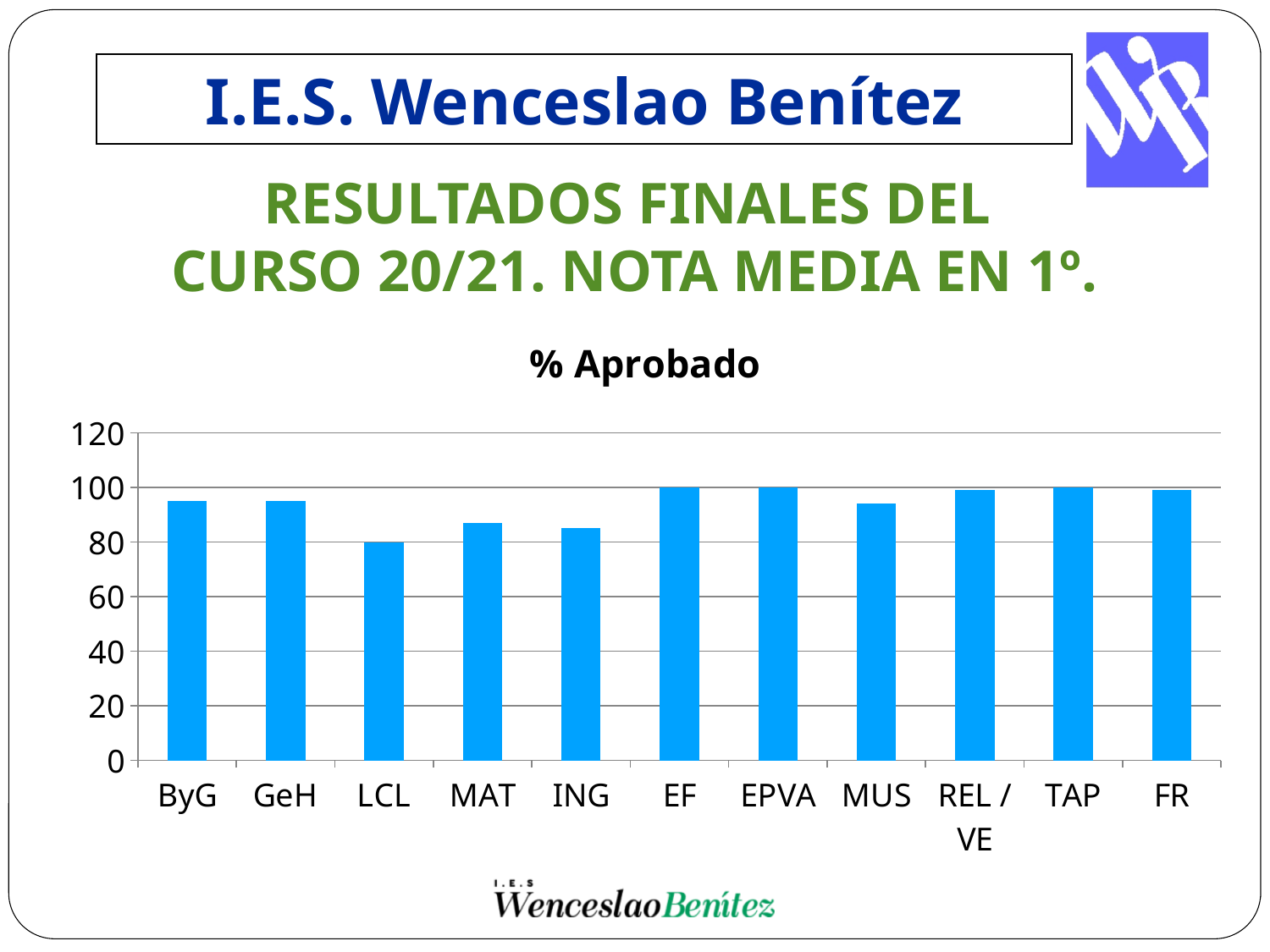
What is the % Aprobado value for EF? 100 Which has a higher % Aprobado, ING or ByG? ByG Which has a higher % Aprobado, MAT or LCL? MAT How many subjects (categories) are shown on the x axis of the chart? 11 Which has a higher % Aprobado, LCL or EF? EF Is the value for ING greater or less than 100? less What kind of chart is shown on the slide? bar chart Is the value for MAT greater or less than 100? less Which subject has the lowest % Aprobado? LCL What is the % Aprobado value for LCL? 80 What is the title of the chart? % Aprobado Is the value for ByG greater or less than 80? greater